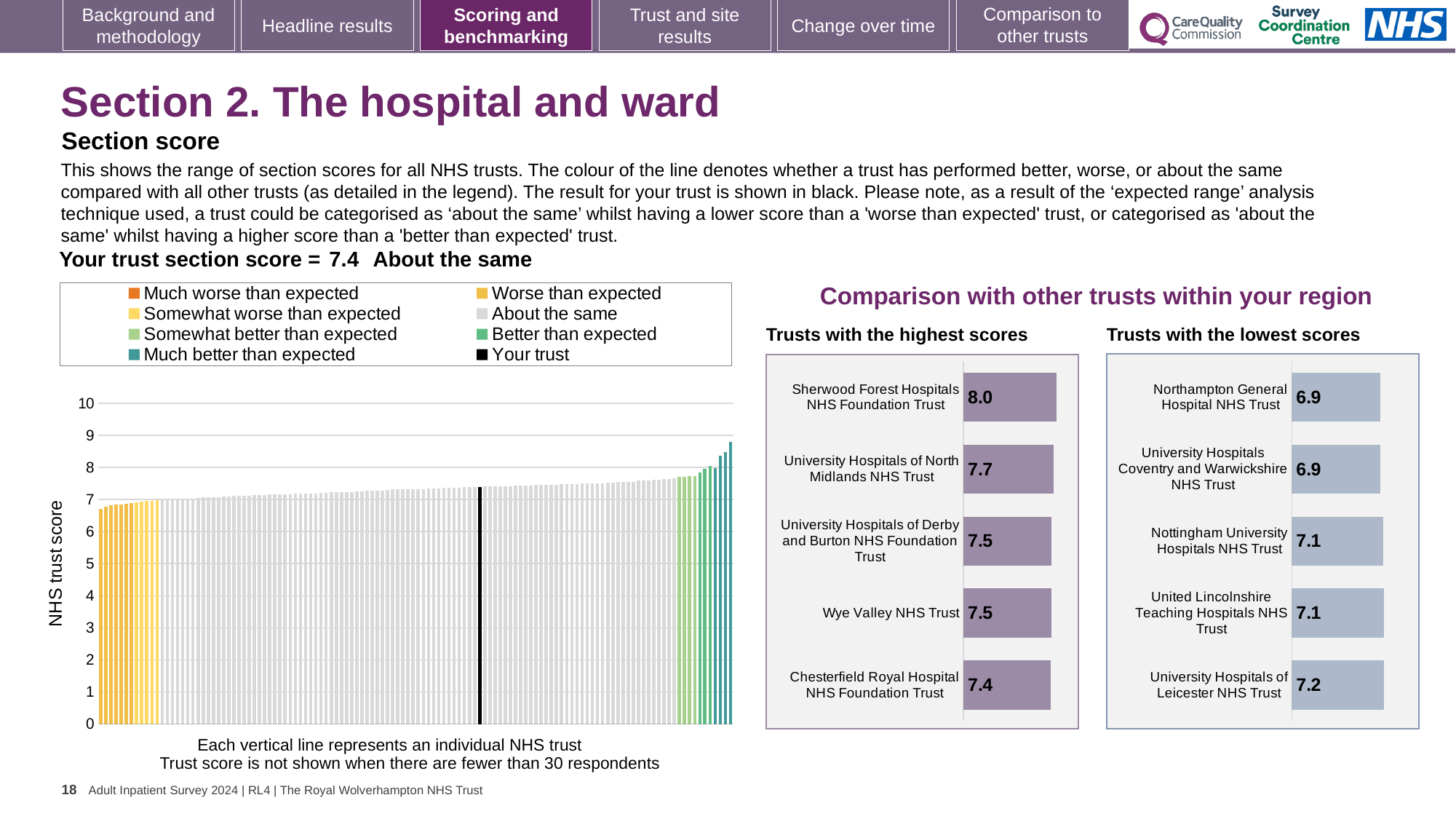
In the 'Trusts with the highest scores' chart, what is the score for Sherwood Forest Hospitals NHS Foundation Trust? 8.0 How many entries does the legend of the main NHS trust score chart list? 8 In the 'Trusts with the highest scores' chart, which trust has the highest score? Sherwood Forest Hospitals NHS Foundation Trust In the 'Trusts with the lowest scores' chart, what is the score for University Hospitals of Leicester NHS Trust? 7.2 How many trusts are listed in the 'Trusts with the lowest scores' chart? 5 In the 'Trusts with the highest scores' chart, what is the difference between the scores of Sherwood Forest Hospitals NHS Foundation Trust and Chesterfield Royal Hospital NHS Foundation Trust? 0.6 In the 'Trusts with the lowest scores' chart, which trust has the highest score shown? University Hospitals of Leicester NHS Trust In the main NHS trust score chart on the left, do the bar values rise or fall from left to right? rise In the 'Trusts with the lowest scores' chart, what is the difference between the scores of University Hospitals of Leicester NHS Trust and Northampton General Hospital NHS Trust? 0.3 In the main NHS trust score chart on the left, is the value of the tallest bar greater or less than 8? greater In the 'Trusts with the highest scores' chart, which has the larger score: University Hospitals of North Midlands NHS Trust or Wye Valley NHS Trust? University Hospitals of North Midlands NHS Trust In the 'Trusts with the highest scores' chart, what is the score for University Hospitals of North Midlands NHS Trust? 7.7